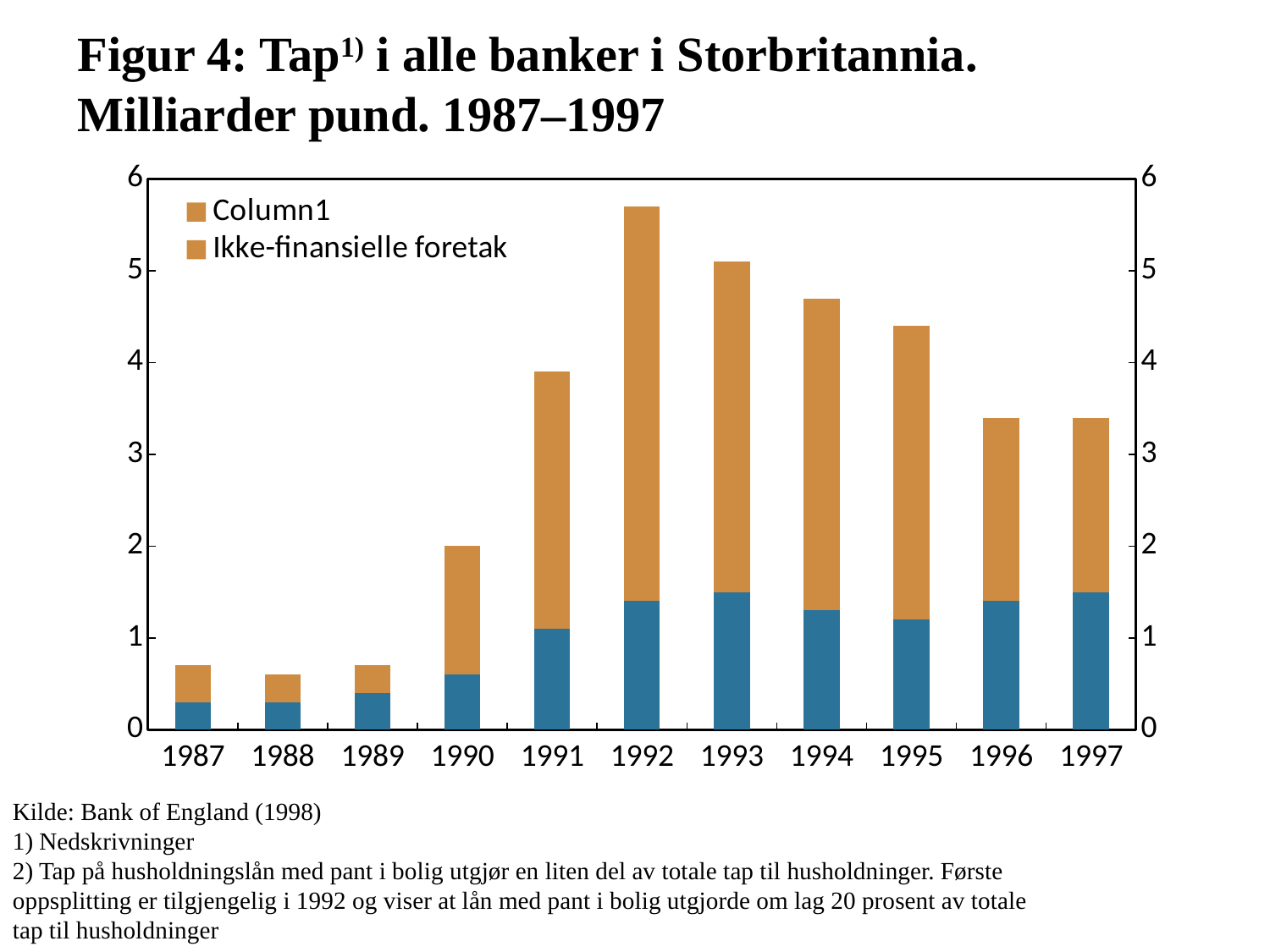
How many series does the legend list? 2 Is the total bar for 1987 greater or less than 1? less Which year has the larger total bar, 1992 or 1993? 1992 What source is cited below the chart? Bank of England (1998) How many years are shown on the x axis of the chart? 11 Which year has the larger total bar, 1991 or 1996? 1991 Is the total bar for 1992 greater or less than 5? greater Is the total bar for 1996 greater or less than 4? less What kind of chart is shown on the slide? Stacked bar chart Which year has the highest total bar? 1992 Do the total bars rise or fall from 1987 to 1992? rise